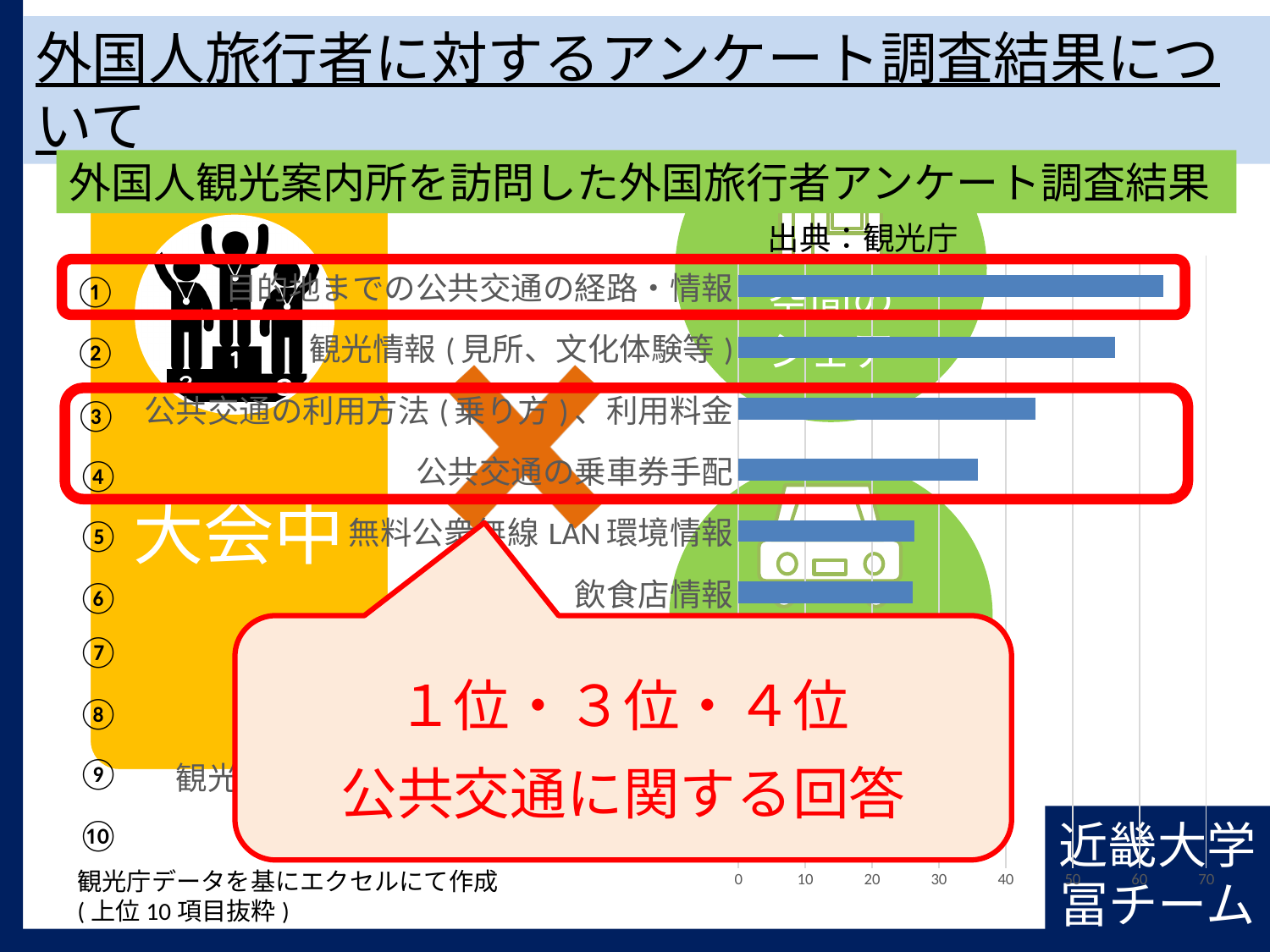
Is the value for 公共交通の乗車券手配 greater or less than 30? greater Which is larger, the value for 観光情報(見所、文化体験等) or the value for 公共交通の乗車券手配? 観光情報(見所、文化体験等) Which category has the longest bar in the chart? 目的地までの公共交通の経路・情報 Is the value for 無料公衆無線LAN環境情報 greater or less than 30? less Is the value for 目的地までの公共交通の経路・情報 greater or less than 60? greater What kind of chart is shown on the slide? bar chart Do the bar values rise or fall going from the top category to the bottom category? fall How many ranked categories does the chart list? 10 What is the highest tick value shown on the horizontal axis? 70 Which is larger, the value for 目的地までの公共交通の経路・情報 or the value for 公共交通の利用方法(乗り方)、利用料金? 目的地までの公共交通の経路・情報